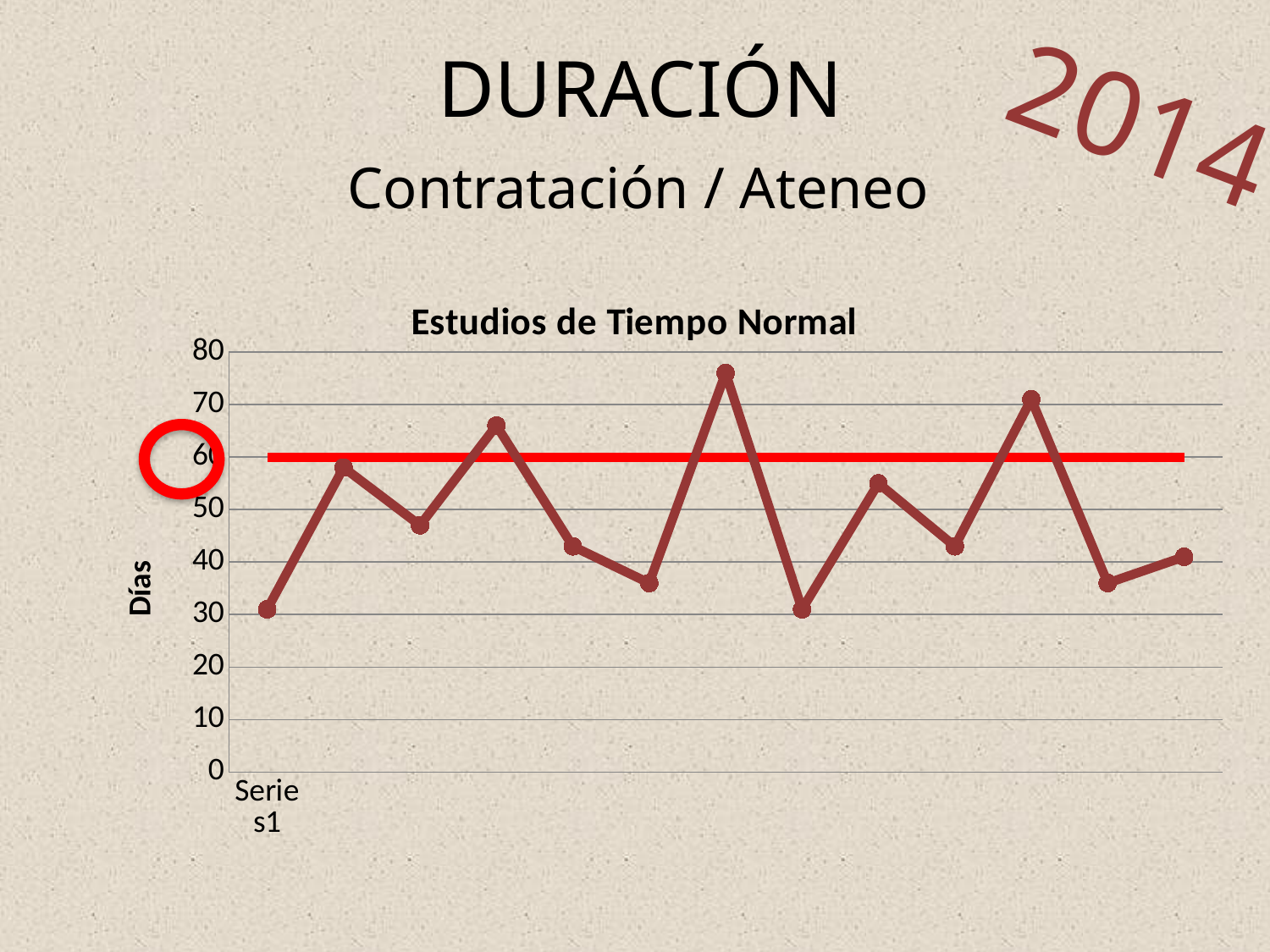
Is the value of the last data point greater or less than 50? less Does the line rise or fall from the first data point to the second data point? rise How many data points are plotted on the line in the chart? 13 What is the title of the chart? Estudios de Tiempo Normal Is the value of the seventh (highest) data point greater or less than 70? greater Which data point has the highest value on the chart? the seventh point Is the value of the first data point greater or less than 40? less Which is larger, the second data point or the third data point? the second data point What kind of chart is shown on the slide? line chart Does the line rise or fall from the seventh data point to the eighth data point? fall At what value on the Días axis is the red horizontal line drawn? 60